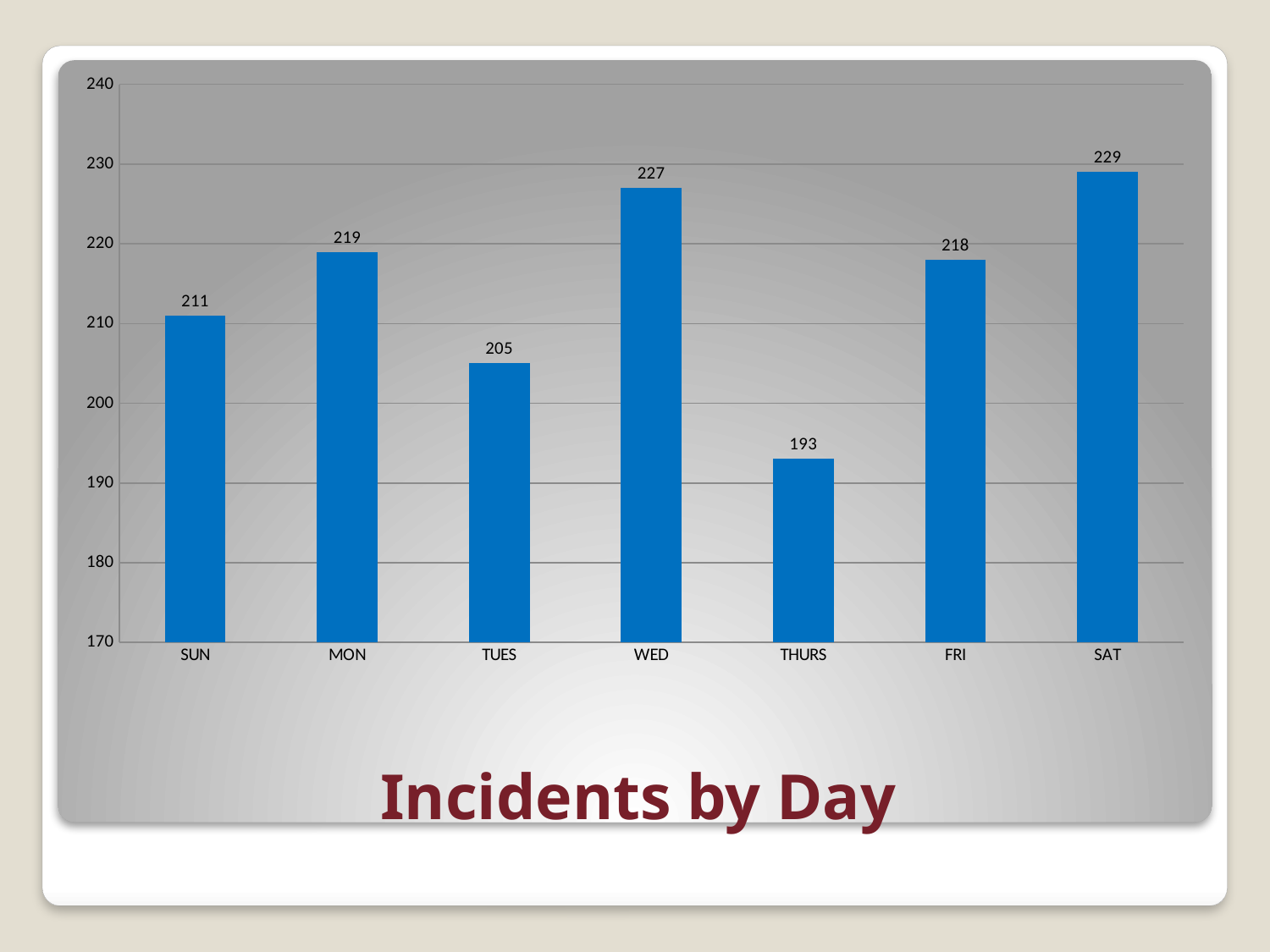
What is the difference between the values for MON and TUES? 14 Which day has the lowest value? THURS What is the value for WED? 227 Which is larger, the value for MON or the value for FRI? MON What kind of chart is shown on the slide? bar chart Which day has the highest value? SAT Is the value for TUES greater or less than 210? less What is the difference between the values for SAT and THURS? 36 What is the value for SUN? 211 What is the title of the chart? Incidents by Day What is the value for THURS? 193 How many days are shown on the x axis? 7